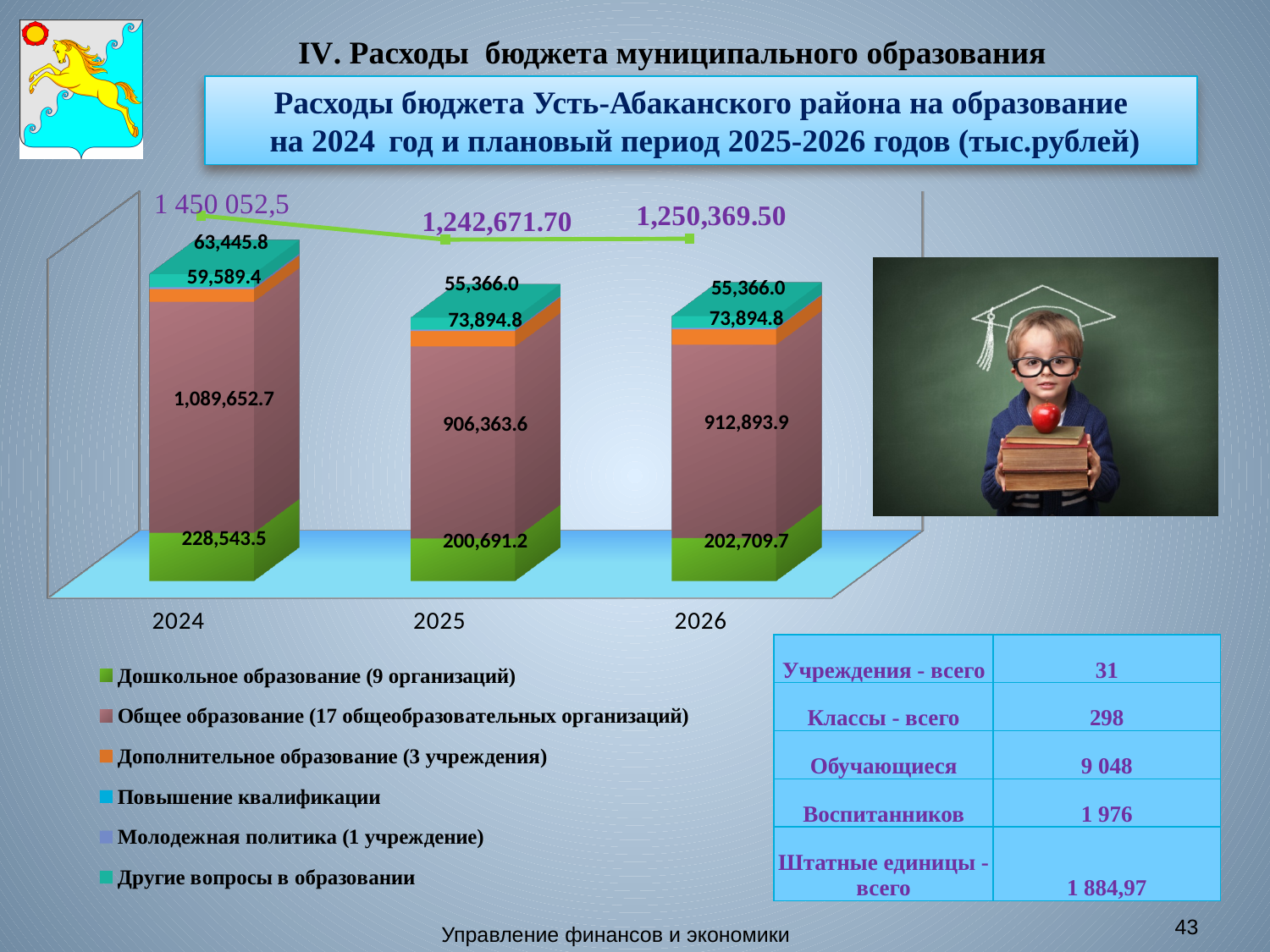
What total value is labelled above the 2024 bar? 1 450 052,5 What kind of chart is shown on the slide? bar chart How many series does the chart legend list? 6 In which year is the value for Общее образование the highest? 2024 What is the value for Дошкольное образование in 2026? 202,709.7 What is the difference between the Общее образование values for 2024 and 2025? 183,289.1 How many years are shown on the x axis of the chart? 3 Which year has the larger value for Дошкольное образование, 2024 or 2025? 2024 What is the value for Общее образование in 2026? 912,893.9 What is the value for Дошкольное образование in 2024? 228,543.5 What is the value for Общее образование in 2025? 906,363.6 In which year is the value for Дошкольное образование the lowest? 2025